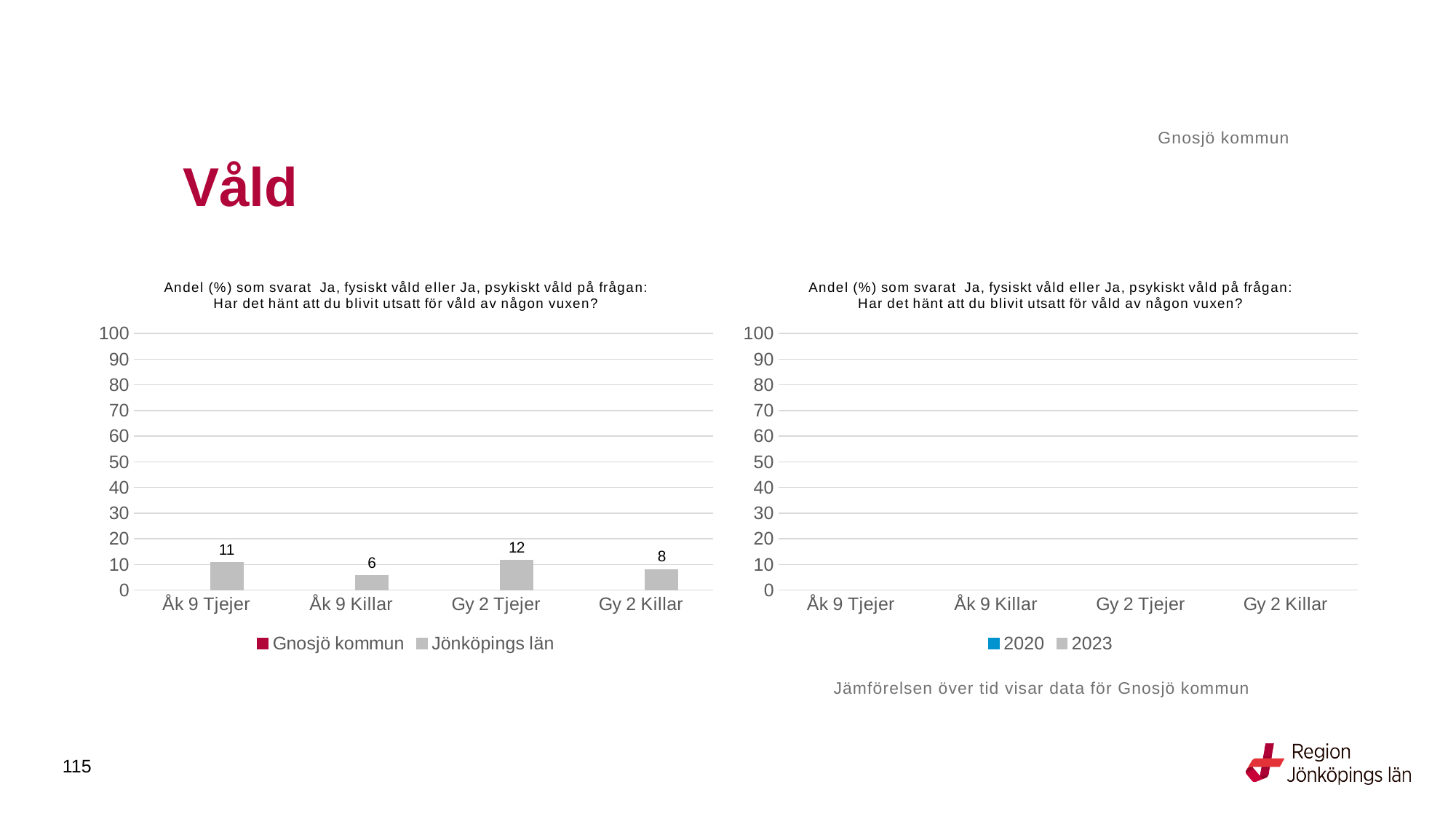
In the left chart, which is larger for Jönköpings län: Åk 9 Tjejer or Gy 2 Killar? Åk 9 Tjejer In the left chart, what is the value for Jönköpings län for Gy 2 Tjejer? 12 In the left chart, how many series does the legend list? 2 In the left chart, what is the value for Jönköpings län for Gy 2 Killar? 8 In the left chart, what is the value for Jönköpings län for Åk 9 Tjejer? 11 In the left chart, which category has the lowest value for Jönköpings län? Åk 9 Killar What kind of chart is the left chart? Bar chart In the left chart, what is the difference between the Jönköpings län values for Gy 2 Tjejer and Åk 9 Killar? 6 In the right chart, what are the two entries in the legend? 2020 and 2023 In the left chart, how many categories are shown on the x axis? 4 In the left chart, which category has the highest value for Jönköpings län? Gy 2 Tjejer In the left chart, what is the value for Jönköpings län for Åk 9 Killar? 6